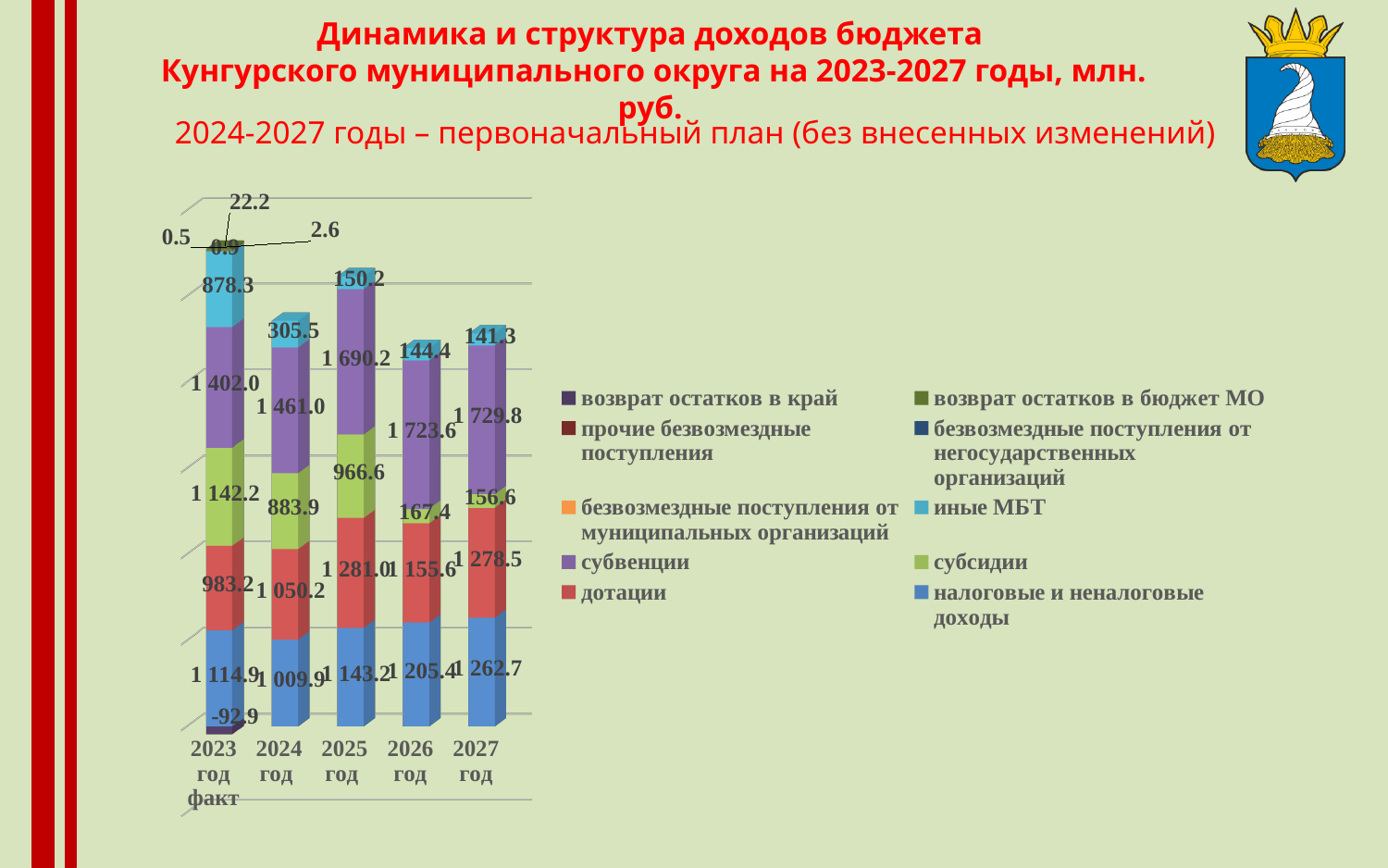
What is the difference between the субвенции values for 2027 год and 2023 год факт? 327.8 In which year is the value for иные МБТ the lowest? 2027 год What is the value for иные МБТ in 2023 год факт? 878.3 How many years (categories) are shown on the x axis? 5 What is the value for дотации in 2024 год? 1 050.2 What is the value for налоговые и неналоговые доходы in 2027 год? 1 262.7 Do the values for субвенции rise or fall from 2023 to 2027? rise What is the value for субвенции in 2025 год? 1 690.2 In 2026 год, which is larger: налоговые и неналоговые доходы or дотации? налоговые и неналоговые доходы What kind of chart is shown on the slide? stacked bar chart How many series does the legend list? 10 In which year is the value for субсидии the highest? 2023 год факт